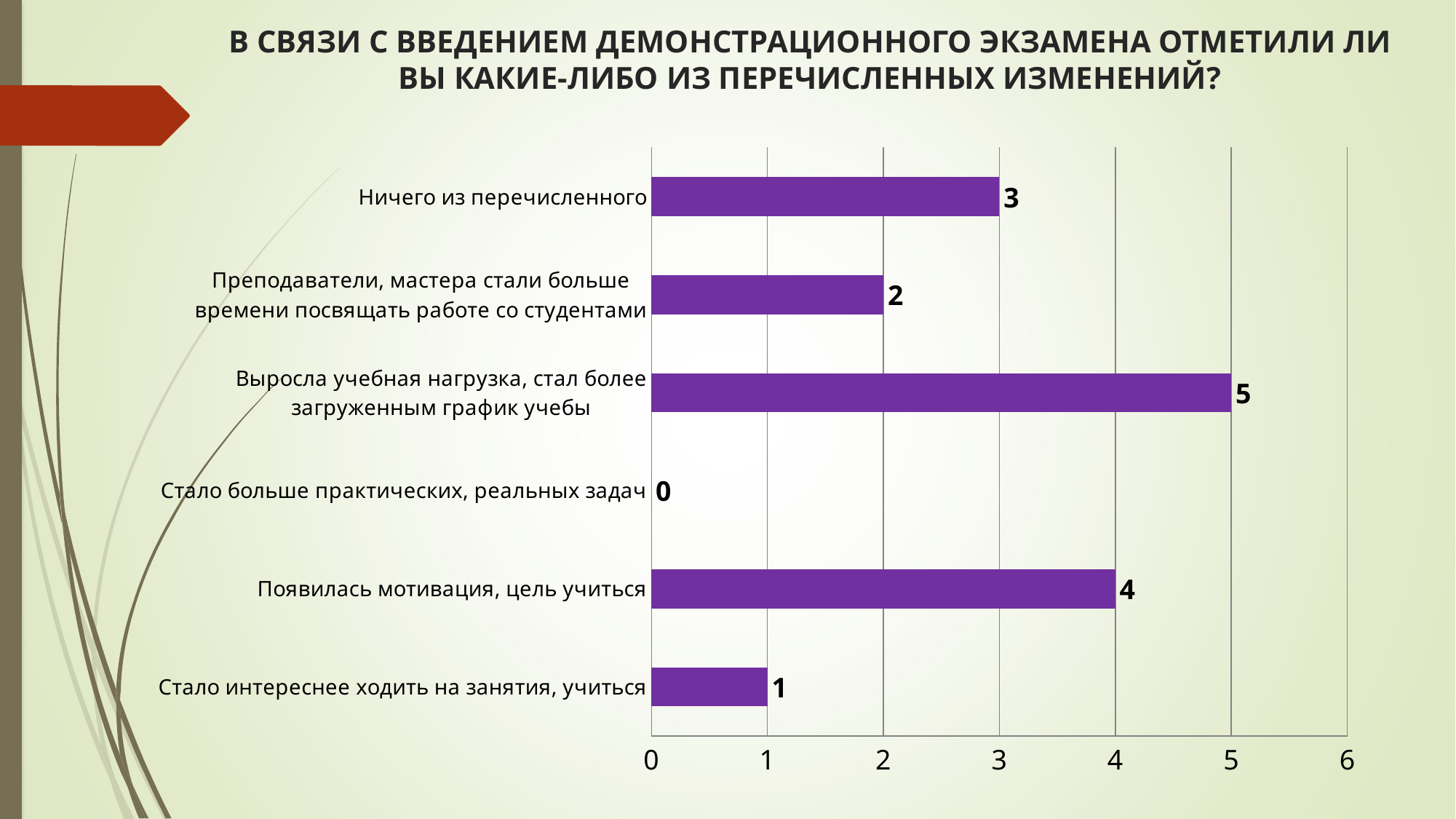
How many categories are shown in the chart? 6 What colour are the bars in the chart? Purple What value is shown for "Стало больше практических, реальных задач"? 0 What kind of chart is shown on the slide? Bar chart What is the difference between the values for "Выросла учебная нагрузка, стал более загруженным график учебы" and "Преподаватели, мастера стали больше времени посвящать работе со студентами"? 3 What value is shown for "Выросла учебная нагрузка, стал более загруженным график учебы"? 5 What is the difference between the values for "Ничего из перечисленного" and "Стало интереснее ходить на занятия, учиться"? 2 Which category has the highest value? Выросла учебная нагрузка, стал более загруженным график учебы Which category has the lowest value? Стало больше практических, реальных задач What value is shown for "Появилась мотивация, цель учиться"? 4 What value is shown for "Ничего из перечисленного"? 3 Which is larger: the value for "Появилась мотивация, цель учиться" or the value for "Ничего из перечисленного"? Появилась мотивация, цель учиться